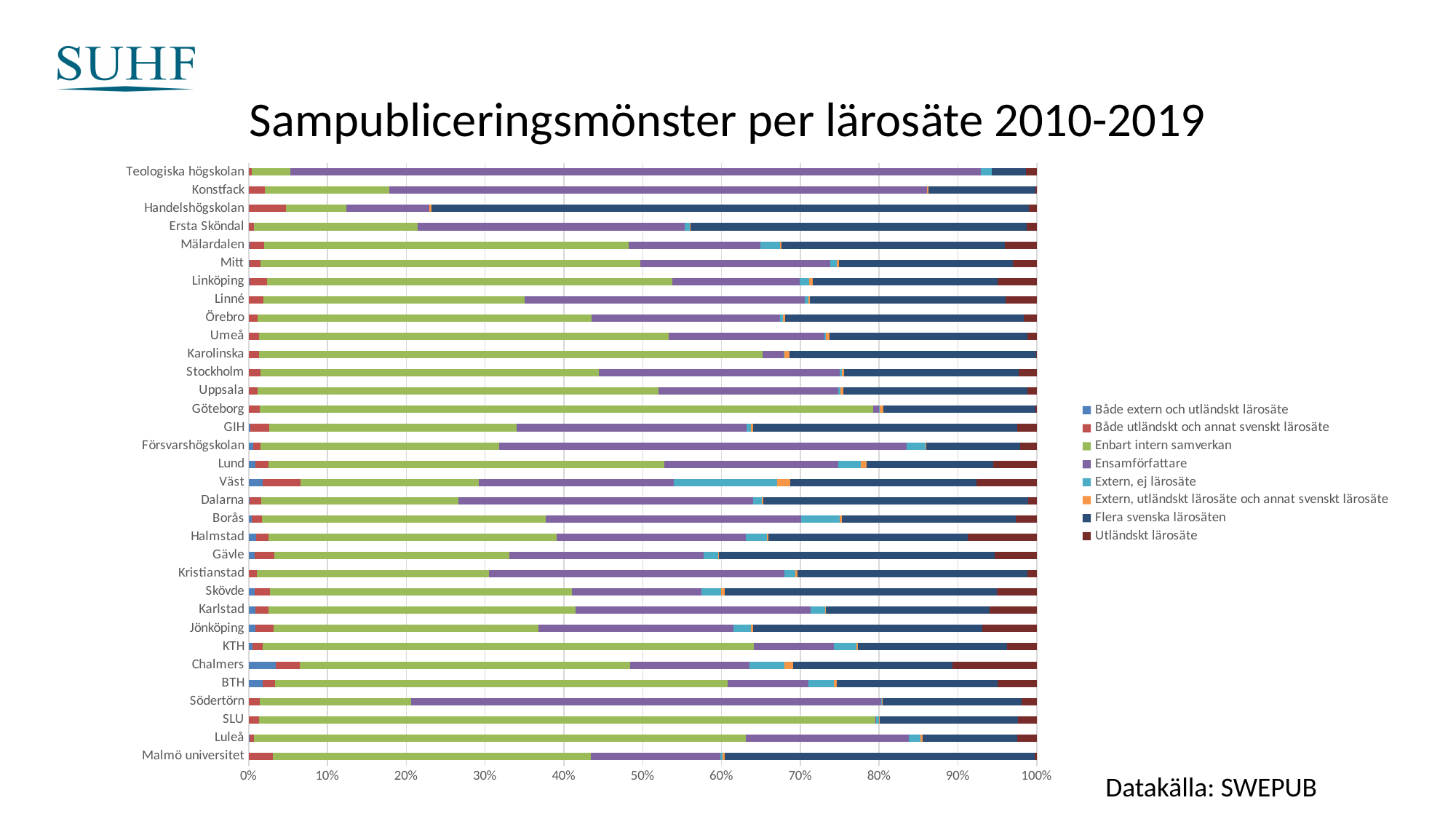
What does each stacked bar total on the x axis? 100% Which has the larger Enbart intern samverkan share, Göteborg or Konstfack? Göteborg How many lärosäten (categories) are plotted on the y axis? 33 Is the Enbart intern samverkan share for Handelshögskolan greater or less than 20%? less Which lärosäte has the largest share of Ensamförfattare? Teologiska högskolan What kind of chart is shown on the slide? Stacked bar chart What is the title of the chart? Sampubliceringsmönster per lärosäte 2010-2019 Is the Enbart intern samverkan share for Göteborg greater or less than 70%? greater Which data source is cited for the chart? SWEPUB Is the Ensamförfattare share for Teologiska högskolan greater or less than 80%? greater How many series does the legend list? 8 Which lärosäte has the largest share of Flera svenska lärosäten? Handelshögskolan